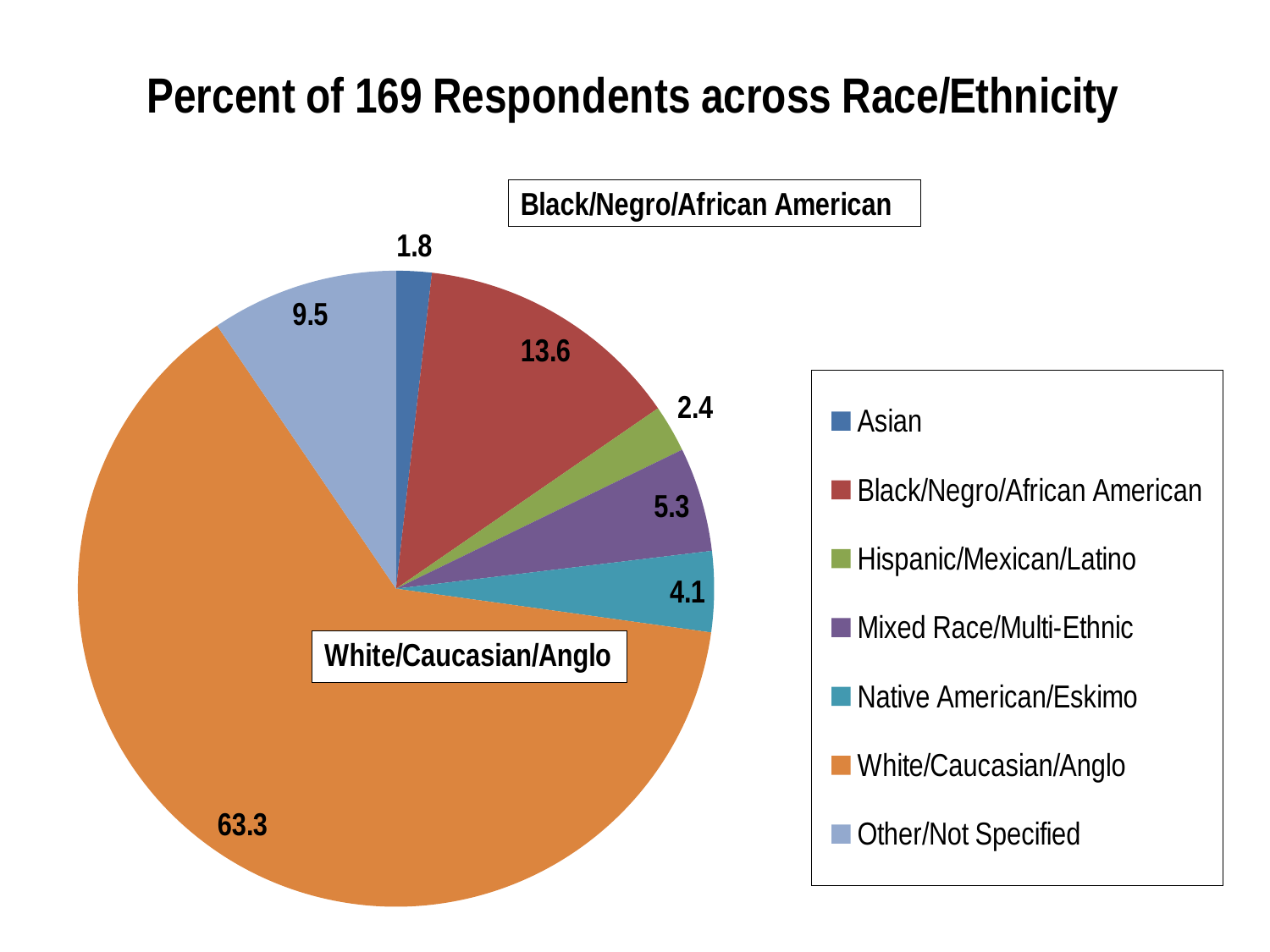
What is the value for White/Caucasian/Anglo? 63.3 Which category has the smallest slice? Asian What is the value for Asian? 1.8 What is the value for Other/Not Specified? 9.5 Which is larger, the value for Mixed Race/Multi-Ethnic or the value for Native American/Eskimo? Mixed Race/Multi-Ethnic What kind of chart is shown on the slide? pie chart How many categories does the pie chart show? 7 Which category has the largest slice? White/Caucasian/Anglo What is the value for Black/Negro/African American? 13.6 What is the title of the chart? Percent of 169 Respondents across Race/Ethnicity What colour is the Hispanic/Mexican/Latino slice? green What is the difference between the values for White/Caucasian/Anglo and Black/Negro/African American? 49.7